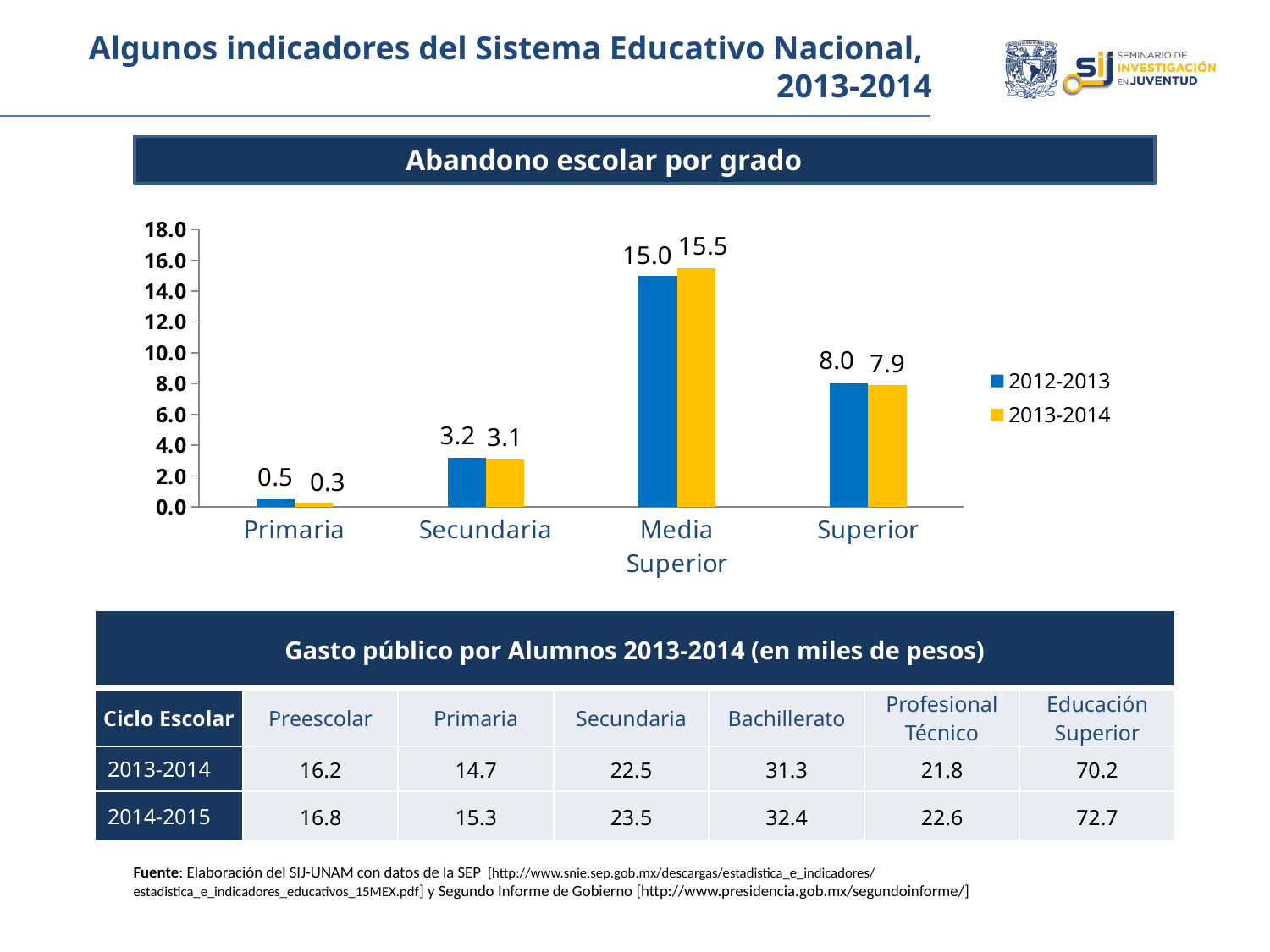
What type of chart is used to show 'Abandono escolar por grado'? Bar chart What is the difference between the 2013-2014 and 2012-2013 values for Media Superior? 0.5 How many series does the legend of the 'Abandono escolar por grado' chart list? 2 Which category has the lowest value in the 2013-2014 series? Primaria What is the value for Media Superior in the 2013-2014 series? 15.5 Is the 2012-2013 value for Superior greater or less than 10.0? less Which is larger for Secundaria: the 2012-2013 value or the 2013-2014 value? 2012-2013 Which series is shown in yellow in the 'Abandono escolar por grado' chart? 2013-2014 What is the value for Primaria in the 2012-2013 series? 0.5 How many categories are shown on the x axis of the 'Abandono escolar por grado' chart? 4 Which category has the highest value in the 2012-2013 series? Media Superior What is the value for Superior in the 2013-2014 series? 7.9